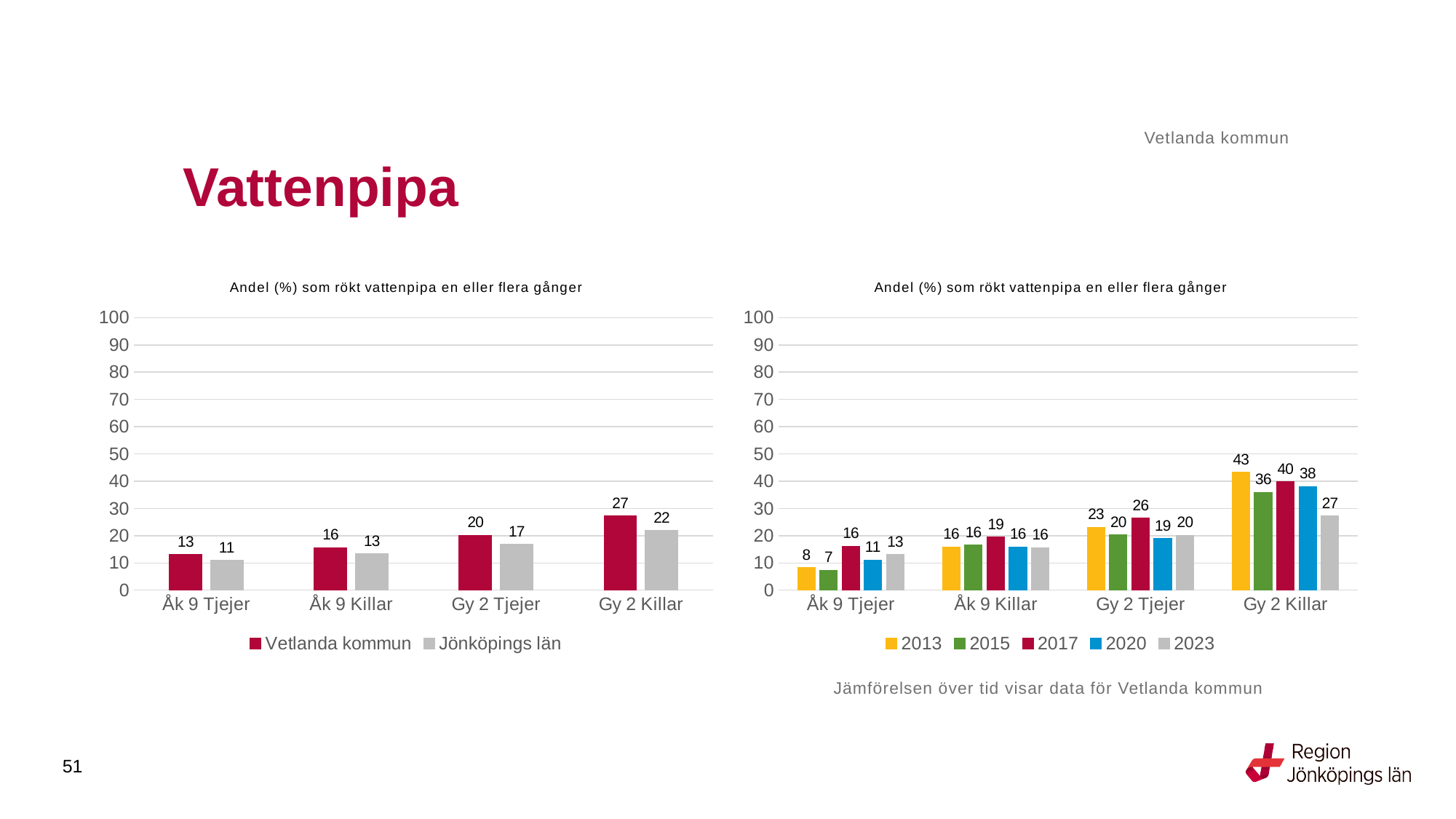
In the left chart, which category has the highest value for Vetlanda kommun? Gy 2 Killar In the right chart, what is the value for 2013 for Gy 2 Killar? 43 In the right chart, which is larger for Gy 2 Tjejer: the value for 2017 or the value for 2020? 2017 In the right chart, what is the value for 2023 for Åk 9 Tjejer? 13 In the right chart, which year has the lowest value for Åk 9 Tjejer? 2015 In the left chart, what is the difference between Vetlanda kommun and Jönköpings län for Gy 2 Killar? 5 In the left chart, what is the value for Jönköpings län for Åk 9 Tjejer? 11 In the right chart, what is the difference between 2013 and 2023 for Gy 2 Killar? 16 In the left chart, how many series does the legend list? 2 In the right chart, how many series does the legend list? 5 In the left chart, what kind of chart is shown? Bar chart In the left chart, what is the value for Vetlanda kommun for Gy 2 Killar? 27